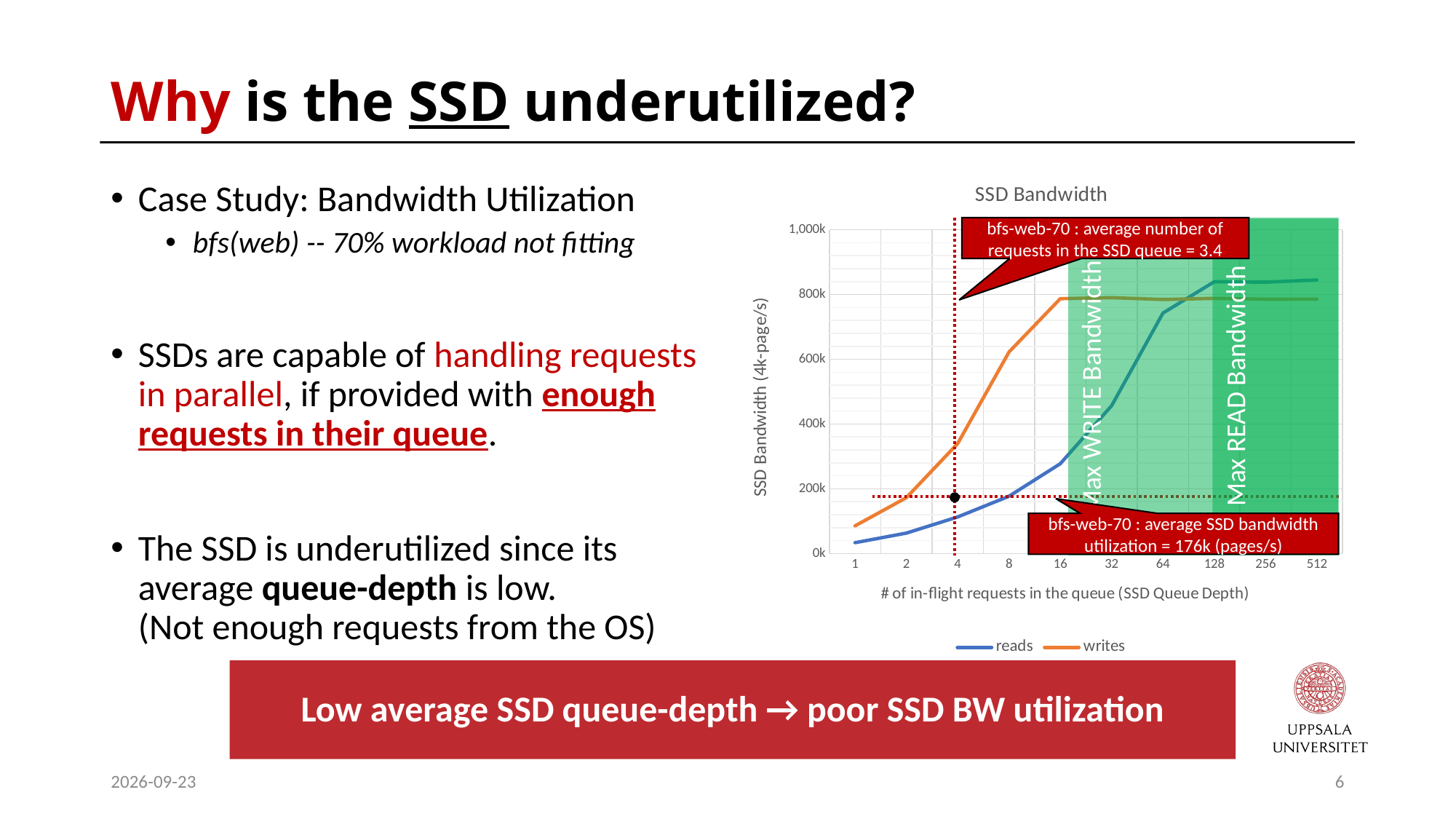
In the SSD Bandwidth chart, is the reads value at queue depth 8 greater or less than 200k? less In the SSD Bandwidth chart, does the reads series rise or fall as the queue depth increases? rise What is the label of the x axis of the SSD Bandwidth chart? # of in-flight requests in the queue (SSD Queue Depth) What kind of chart is the SSD Bandwidth chart? line chart In the SSD Bandwidth chart, is the reads value at queue depth 64 greater or less than 600k? greater According to the annotation on the SSD Bandwidth chart, what is the average number of requests in the SSD queue for bfs-web-70? 3.4 In the SSD Bandwidth chart, is the writes value at queue depth 4 greater or less than 200k? greater How many series does the legend of the SSD Bandwidth chart list? 2 How many queue-depth values are marked on the x axis of the SSD Bandwidth chart? 10 According to the annotation on the SSD Bandwidth chart, what is the average SSD bandwidth utilization for bfs-web-70? 176k (pages/s) In the SSD Bandwidth chart, at a queue depth of 4, which series has the higher bandwidth, reads or writes? writes